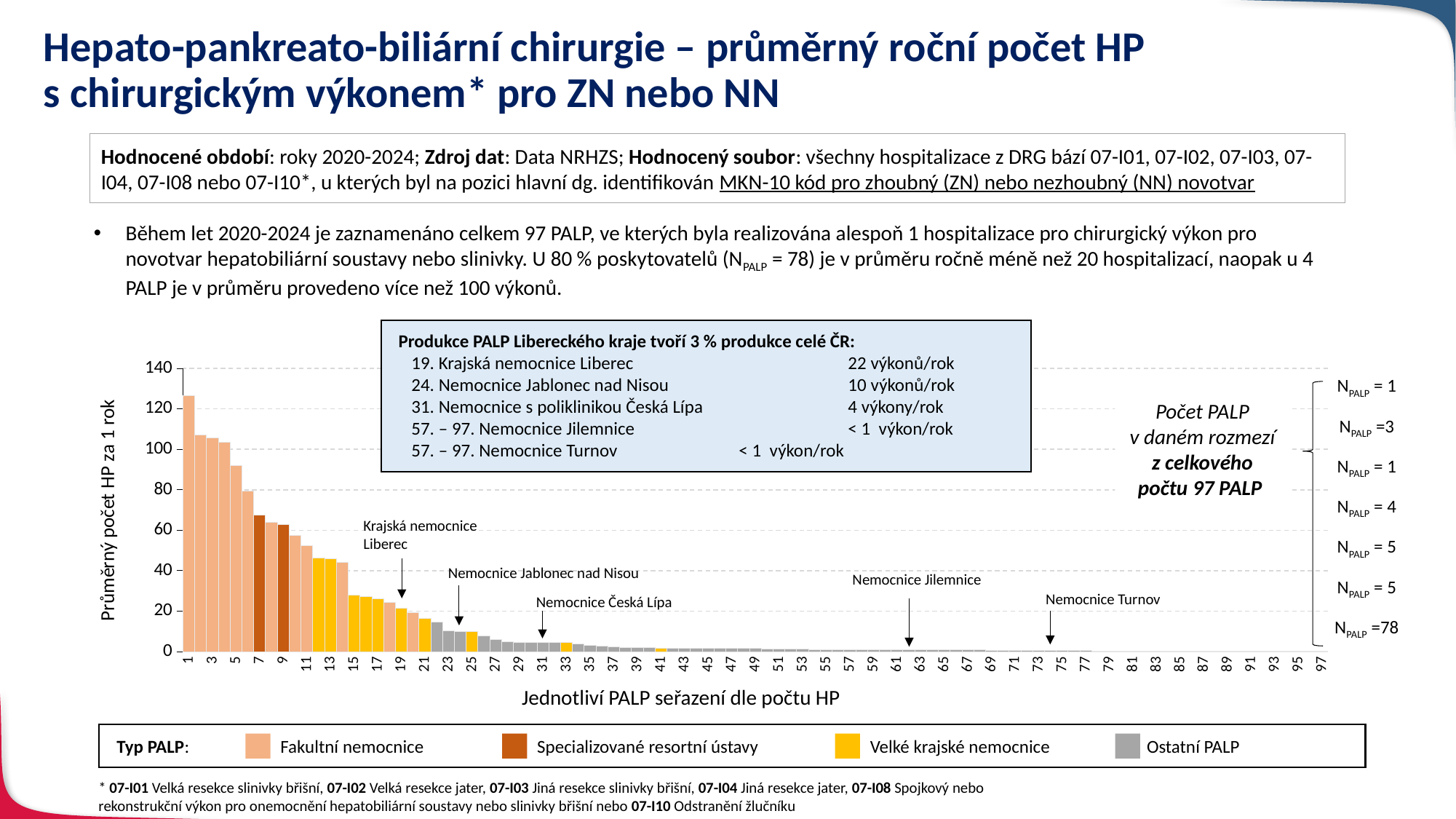
Do the bar values rise or fall from left to right along the x axis? fall What colour does the legend assign to 'Velké krajské nemocnice'? yellow How many PALP (providers) are plotted along the x axis of the chart? 97 What kind of chart is shown on the slide? bar chart What is the difference between the annual procedure counts of Krajská nemocnice Liberec and Nemocnice Jablonec nad Nisou shown in the text box? 12 How many PALP types does the legend 'Typ PALP' list? 4 According to the text box on the chart, what is the average annual number of procedures for Krajská nemocnice Liberec? 22 výkonů/rok What rank position does Krajská nemocnice Liberec hold in the ordering of PALP by number of HP? 19 Which has more procedures per year, Nemocnice Jablonec nad Nisou or Nemocnice s poliklinikou Česká Lípa? Nemocnice Jablonec nad Nisou According to the text box on the chart, what is the average annual number of procedures for Nemocnice s poliklinikou Česká Lípa? 4 výkony/rok According to the text box on the chart, what is the average annual number of procedures for Nemocnice Jablonec nad Nisou? 10 výkonů/rok Is the value for the first (highest) PALP bar greater or less than 120? greater